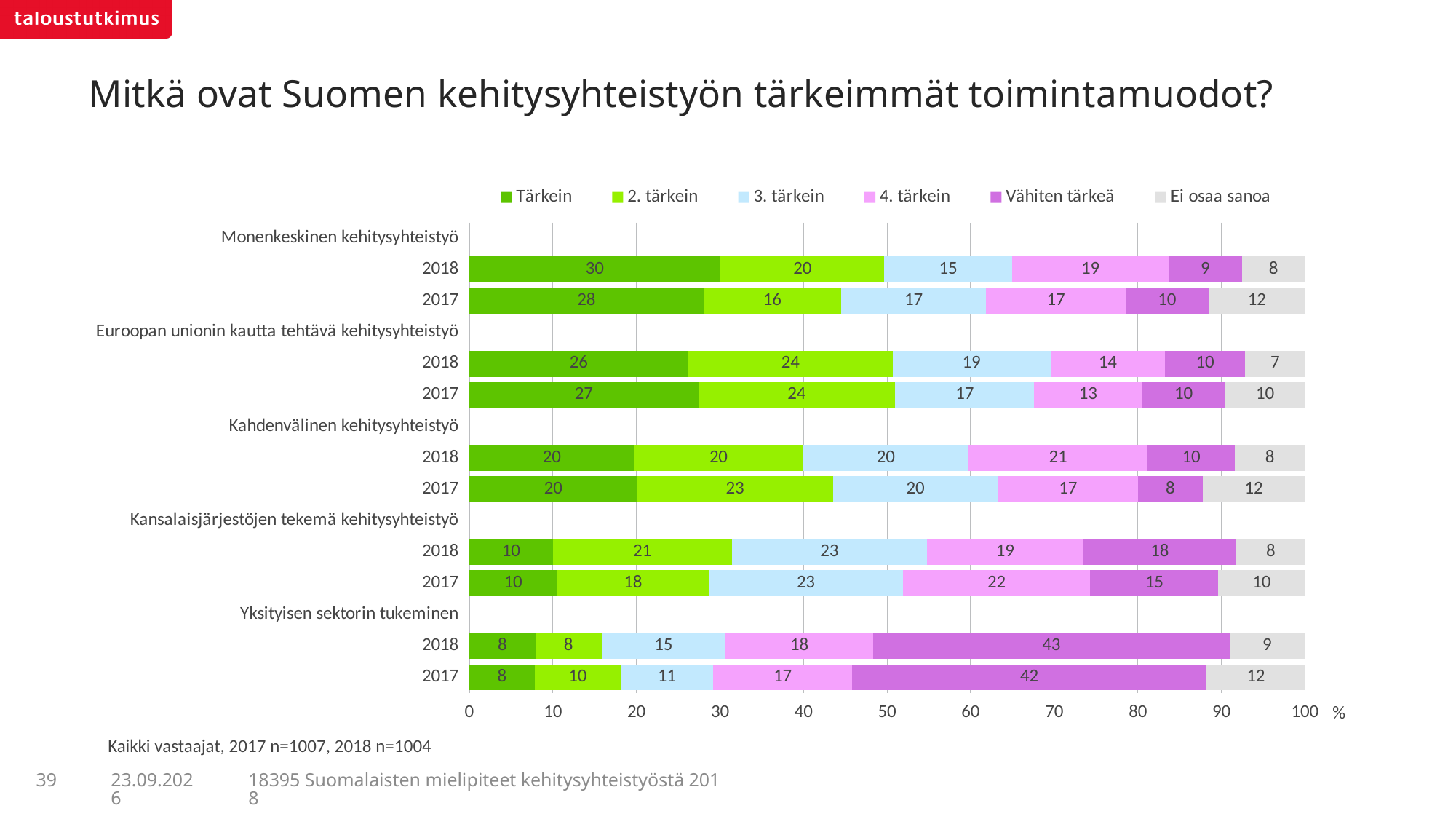
Which bar has the lowest 'Ei osaa sanoa' value? Euroopan unionin kautta tehtävä kehitysyhteistyö 2018 Which is larger: the '2. tärkein' value for Kahdenvälinen kehitysyhteistyö in 2017 or in 2018? 2017 What is the difference between the 'Vähiten tärkeä' values for Yksityisen sektorin tukeminen in 2018 and 2017? 1 How many series does the legend list? 6 What is the 'Ei osaa sanoa' value for Euroopan unionin kautta tehtävä kehitysyhteistyö in 2017? 10 What is the 'Tärkein' value for Monenkeskinen kehitysyhteistyö in 2018? 30 What is the 'Vähiten tärkeä' value for Yksityisen sektorin tukeminen in 2018? 43 What is the total of the stacked bar for Euroopan unionin kautta tehtävä kehitysyhteistyö in 2018? 100 What kind of chart is shown on the slide? Stacked bar chart How many bars are plotted in the chart? 10 What is the title of the slide? Mitkä ovat Suomen kehitysyhteistyön tärkeimmät toimintamuodot? Which bar has the highest 'Tärkein' value? Monenkeskinen kehitysyhteistyö 2018